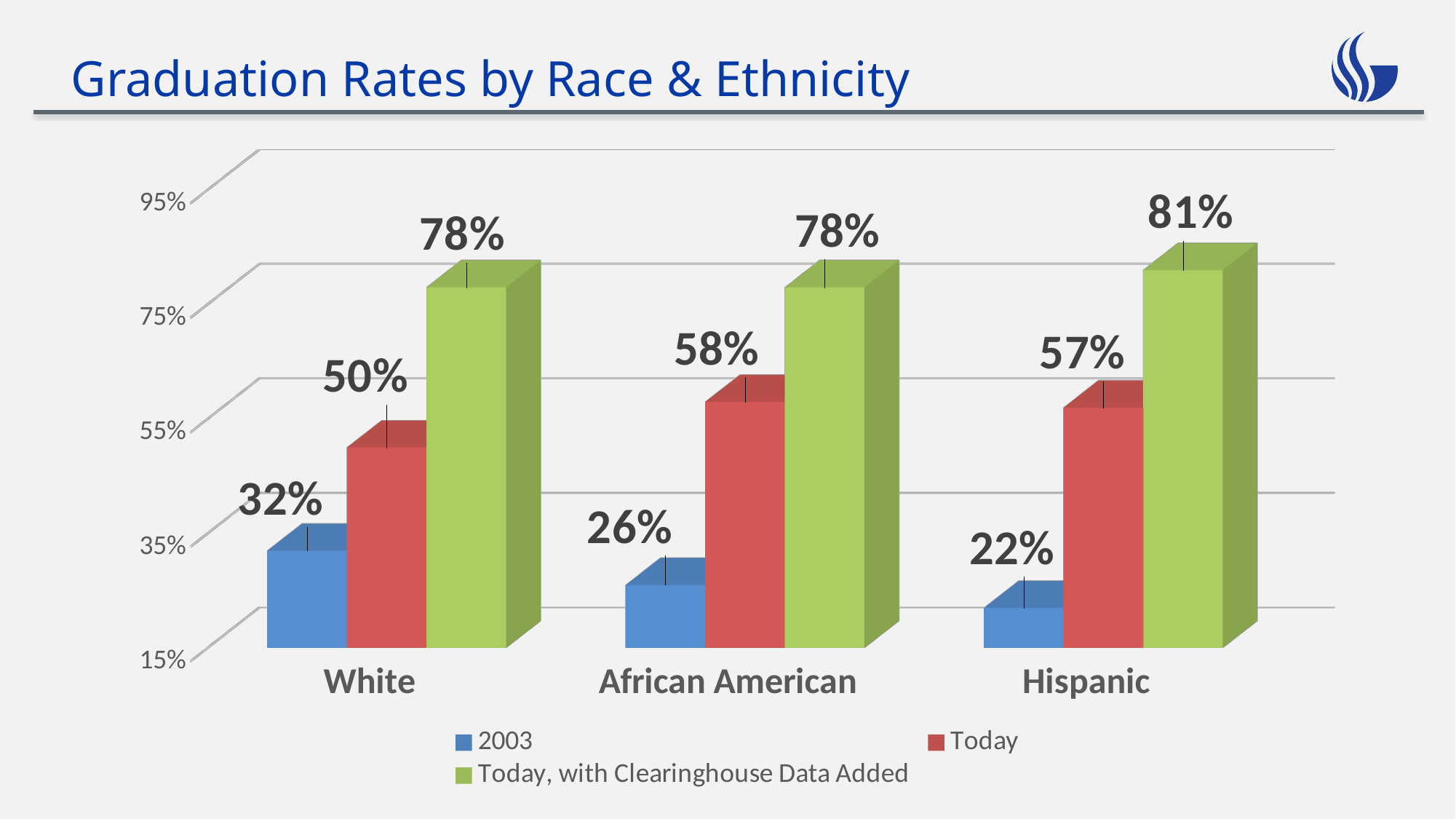
How many series does the legend list? 3 What kind of chart is shown on the slide? Bar chart Which is larger: the Today rate for African American students or the Today rate for White students? African American What is the difference between the 'Today, with Clearinghouse Data Added' rate and the Today rate for Hispanic students? 24% What is the title of the chart? Graduation Rates by Race & Ethnicity Which group has the highest value in the 'Today, with Clearinghouse Data Added' series? Hispanic What is the 2003 graduation rate for White students? 32% What is the Today graduation rate for African American students? 58% What is the graduation rate for Hispanic students in the 'Today, with Clearinghouse Data Added' series? 81% Which group has the lowest 2003 graduation rate? Hispanic How many race/ethnicity groups are shown on the x axis? 3 What is the difference between the Today rate and the 2003 rate for White students? 18%